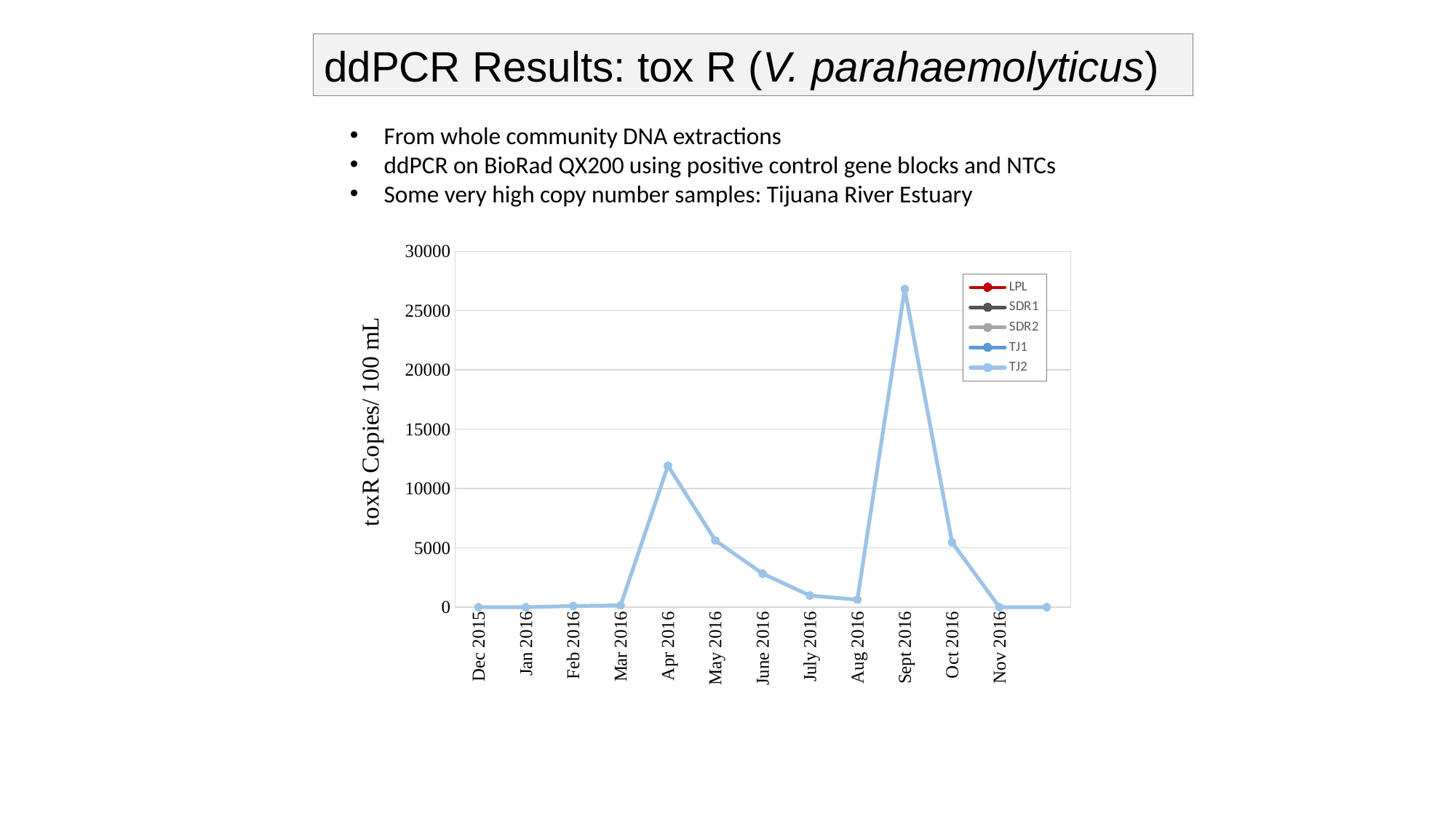
Is the TJ2 value for Oct 2016 greater or less than 10000? less What is the label of the chart's vertical axis? toxR Copies/ 100 mL Is the TJ2 value for May 2016 greater or less than 10000? less How many series does the chart's legend list? 5 Do the TJ2 values rise or fall from Apr 2016 to Aug 2016? fall Which series are listed in the chart's legend? LPL, SDR1, SDR2, TJ1, TJ2 In which month does the TJ2 series reach its highest value? Sept 2016 Is the TJ2 value for Sept 2016 greater or less than 25000? greater Which month has the larger TJ2 value, May 2016 or July 2016? May 2016 What kind of chart is shown on the slide? line chart Which month has the larger TJ2 value, Apr 2016 or Sept 2016? Sept 2016